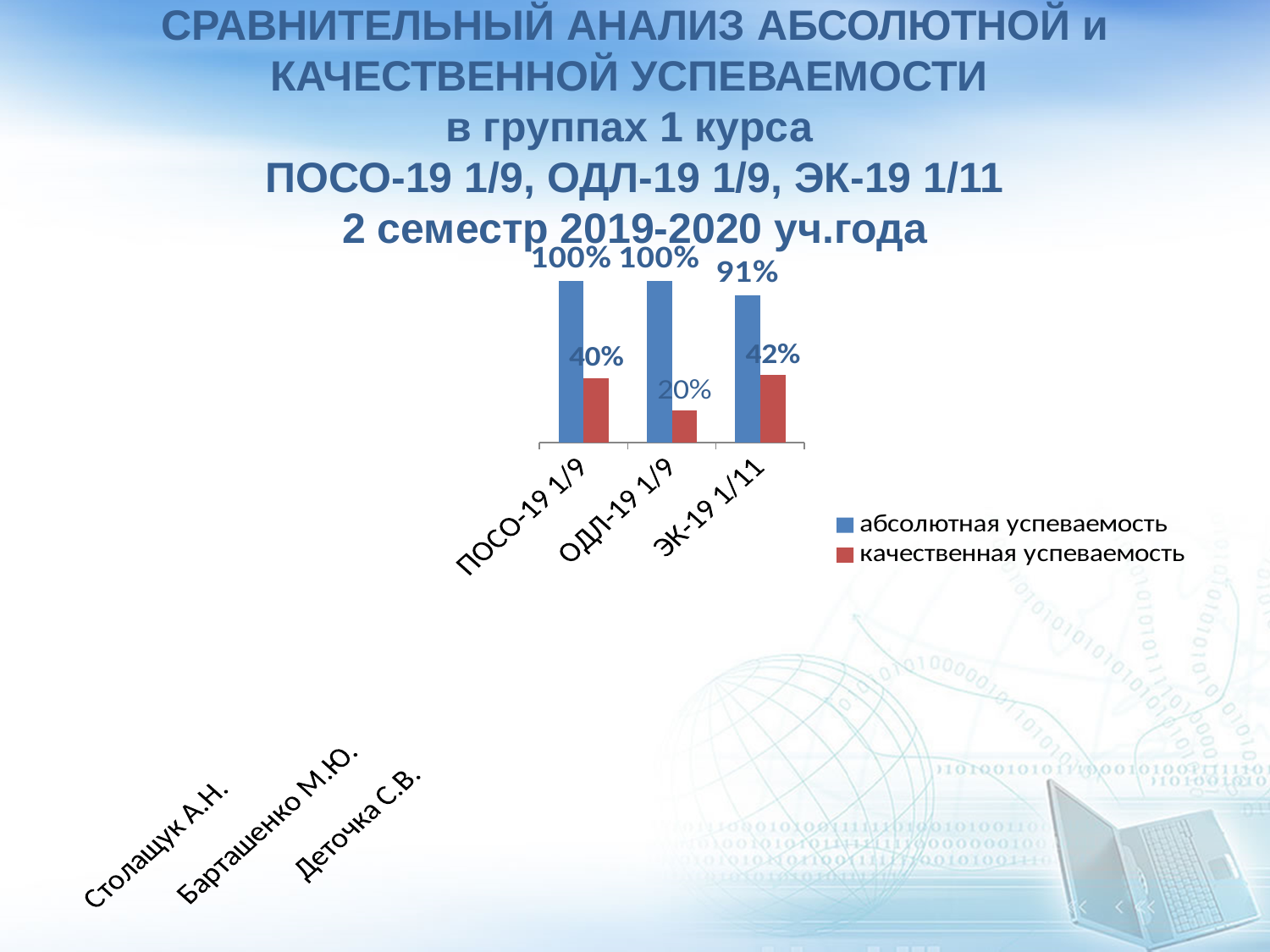
What is the абсолютная успеваемость value for ЭК-19 1/11? 91% How many groups (categories) are shown on the x axis? 3 Which is larger: the качественная успеваемость for ПОСО-19 1/9 or for ОДЛ-19 1/9? ПОСО-19 1/9 What is the difference between абсолютная and качественная успеваемость for ОДЛ-19 1/9? 80% How many series does the legend list? 2 What type of chart is shown on the slide? bar chart Which series is shown in red in the legend? качественная успеваемость What is the абсолютная успеваемость value for ПОСО-19 1/9? 100% Which group has the lowest абсолютная успеваемость? ЭК-19 1/11 Which group has the lowest качественная успеваемость? ОДЛ-19 1/9 What is the качественная успеваемость value for ЭК-19 1/11? 42% What is the качественная успеваемость value for ОДЛ-19 1/9? 20%